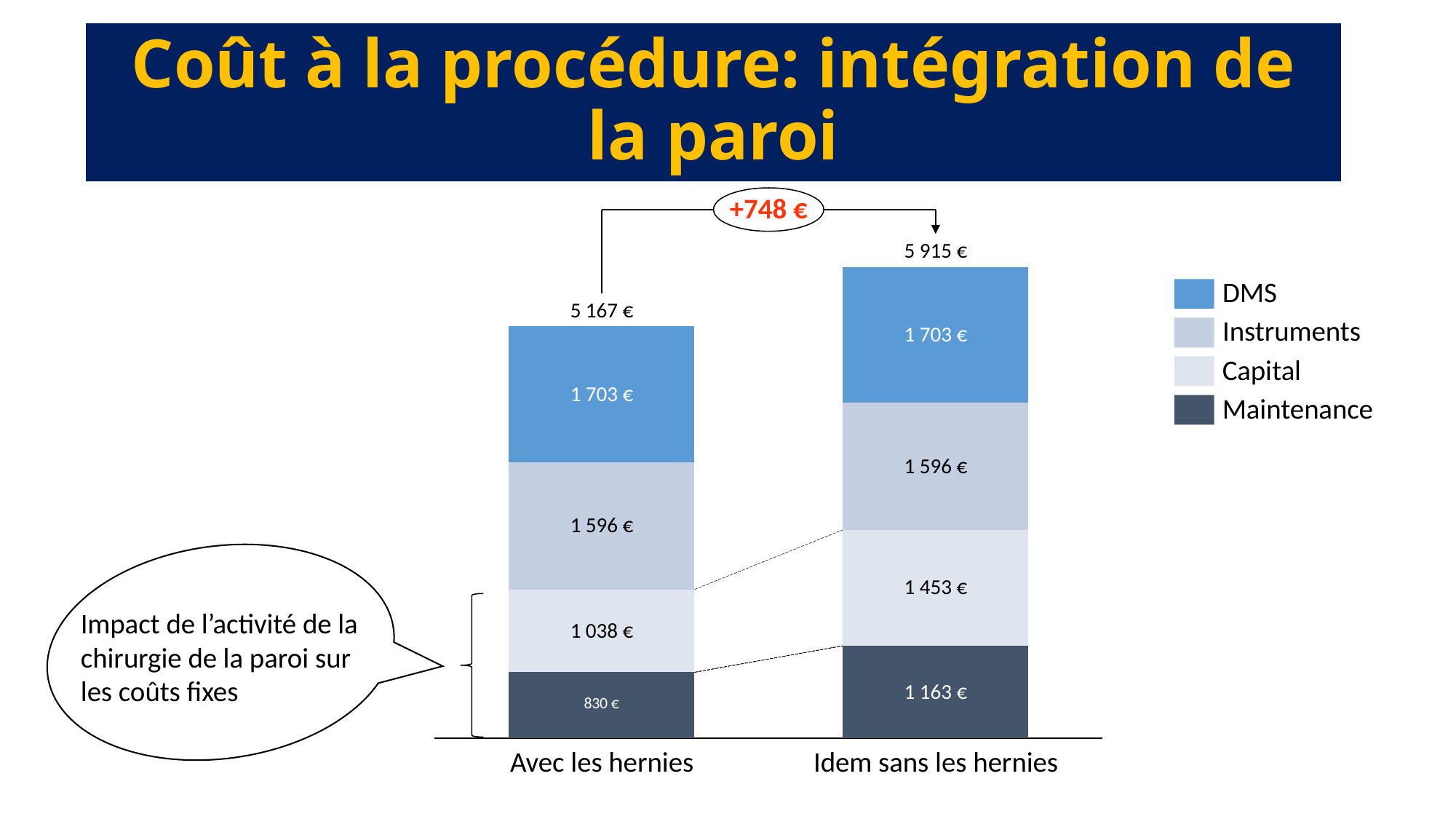
What is the Maintenance value for "Avec les hernies"? 830 € What is the total of the stacked bar for "Avec les hernies"? 5 167 € What is the DMS value for "Idem sans les hernies"? 1 703 € What is the Capital value for "Idem sans les hernies"? 1 453 € What type of chart is shown on the slide? Stacked bar chart What is the Instruments value for "Avec les hernies"? 1 596 € Which category has the higher Maintenance value, "Avec les hernies" or "Idem sans les hernies"? Idem sans les hernies How many series does the chart legend list? 4 Which series is shown in the darkest colour at the bottom of each bar? Maintenance How many categories are shown on the x axis of the chart? 2 What is the difference between the total for "Idem sans les hernies" and the total for "Avec les hernies"? 748 € What is the total of the stacked bar for "Idem sans les hernies"? 5 915 €